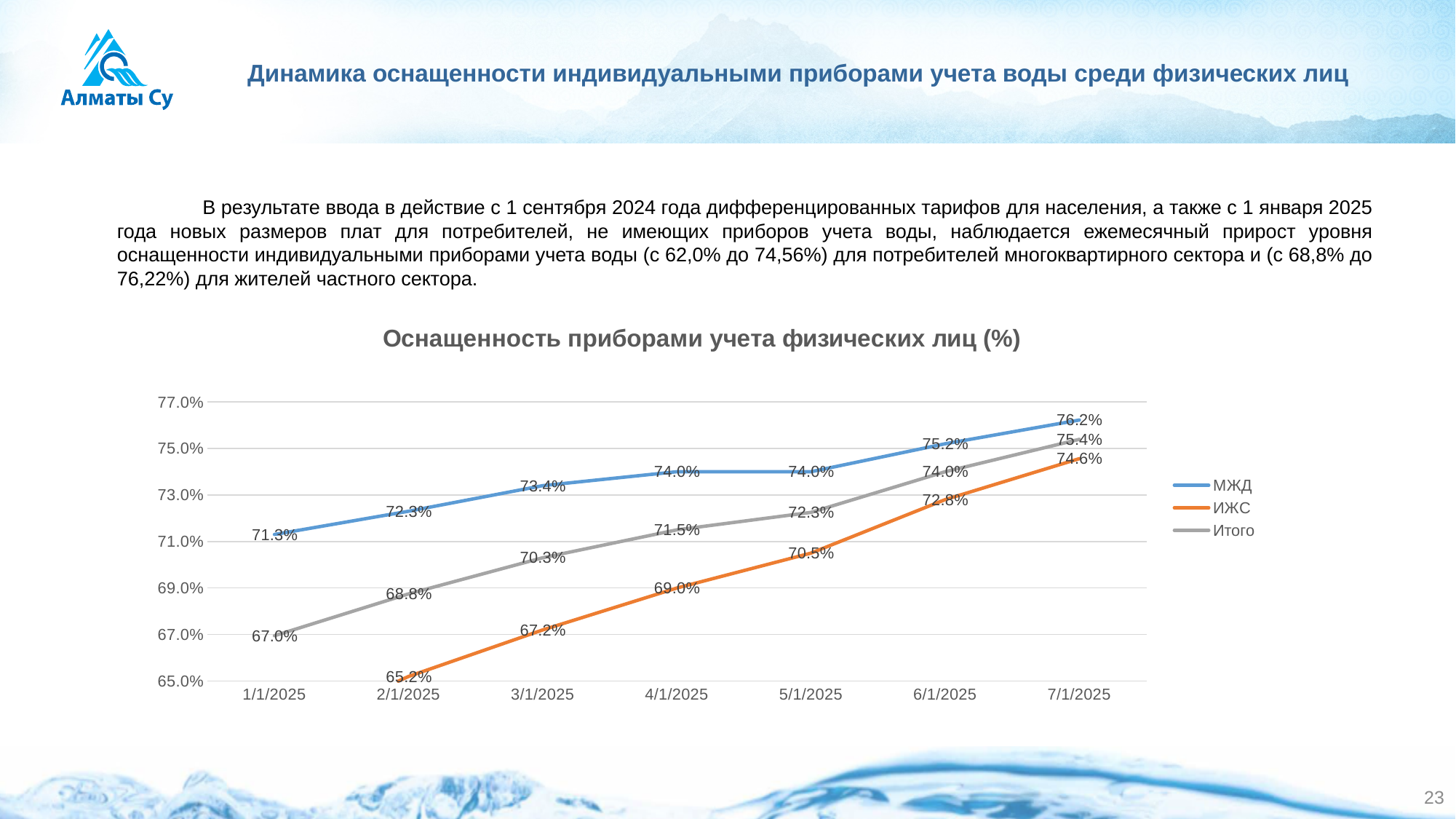
What is the value for ИЖС at 4/1/2025? 69.0% What is the value for МЖД at 7/1/2025? 76.2% Is the value for ИЖС at 5/1/2025 greater or less than 71.0%? less What is the value for Итого at 1/1/2025? 67.0% What is the difference between the МЖД value and the ИЖС value at 7/1/2025? 1.6% Which is larger at 6/1/2025: the value for Итого or the value for ИЖС? Итого Does the Итого series rise or fall from 1/1/2025 to 7/1/2025? rise At which date does the МЖД series reach its highest value? 7/1/2025 What kind of chart is shown on the slide? line chart At which date is the Итого series at its lowest value? 1/1/2025 How many series does the legend list? 3 What is the value for ИЖС at 2/1/2025? 65.2%